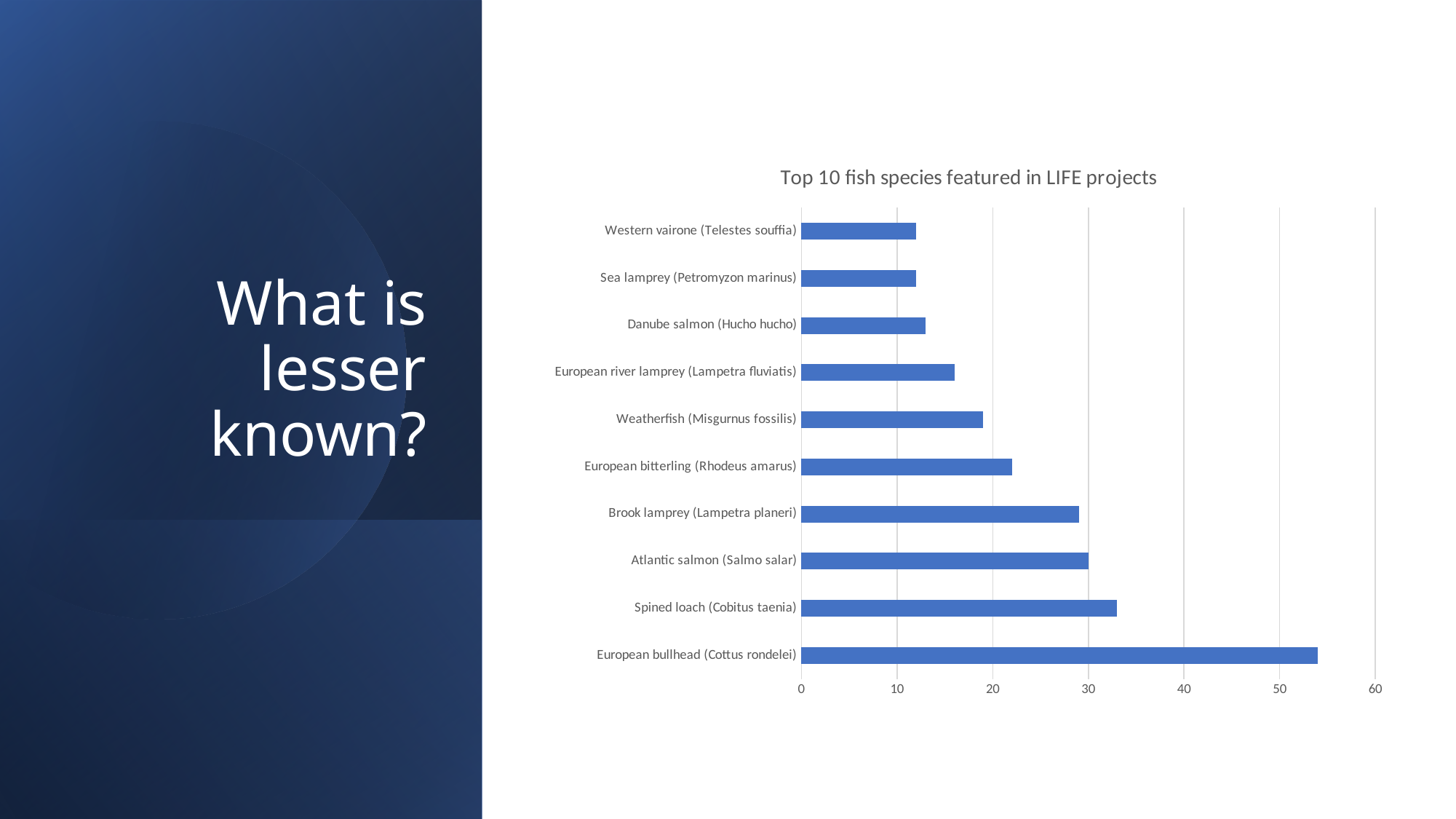
Which has a larger value, European river lamprey (Lampetra fluviatis) or Danube salmon (Hucho hucho)? European river lamprey (Lampetra fluviatis) Which fish species has the highest value in the chart? European bullhead (Cottus rondelei) Which has a larger value, Spined loach (Cobitus taenia) or Atlantic salmon (Salmo salar)? Spined loach (Cobitus taenia) What is the title of the chart? Top 10 fish species featured in LIFE projects How many fish species are shown in the chart? 10 Is the value for Spined loach (Cobitus taenia) greater or less than 30? greater Is the value for European bullhead (Cottus rondelei) greater or less than 50? greater What kind of chart is shown on the slide? bar chart Is the value for Western vairone (Telestes souffia) greater or less than 10? greater